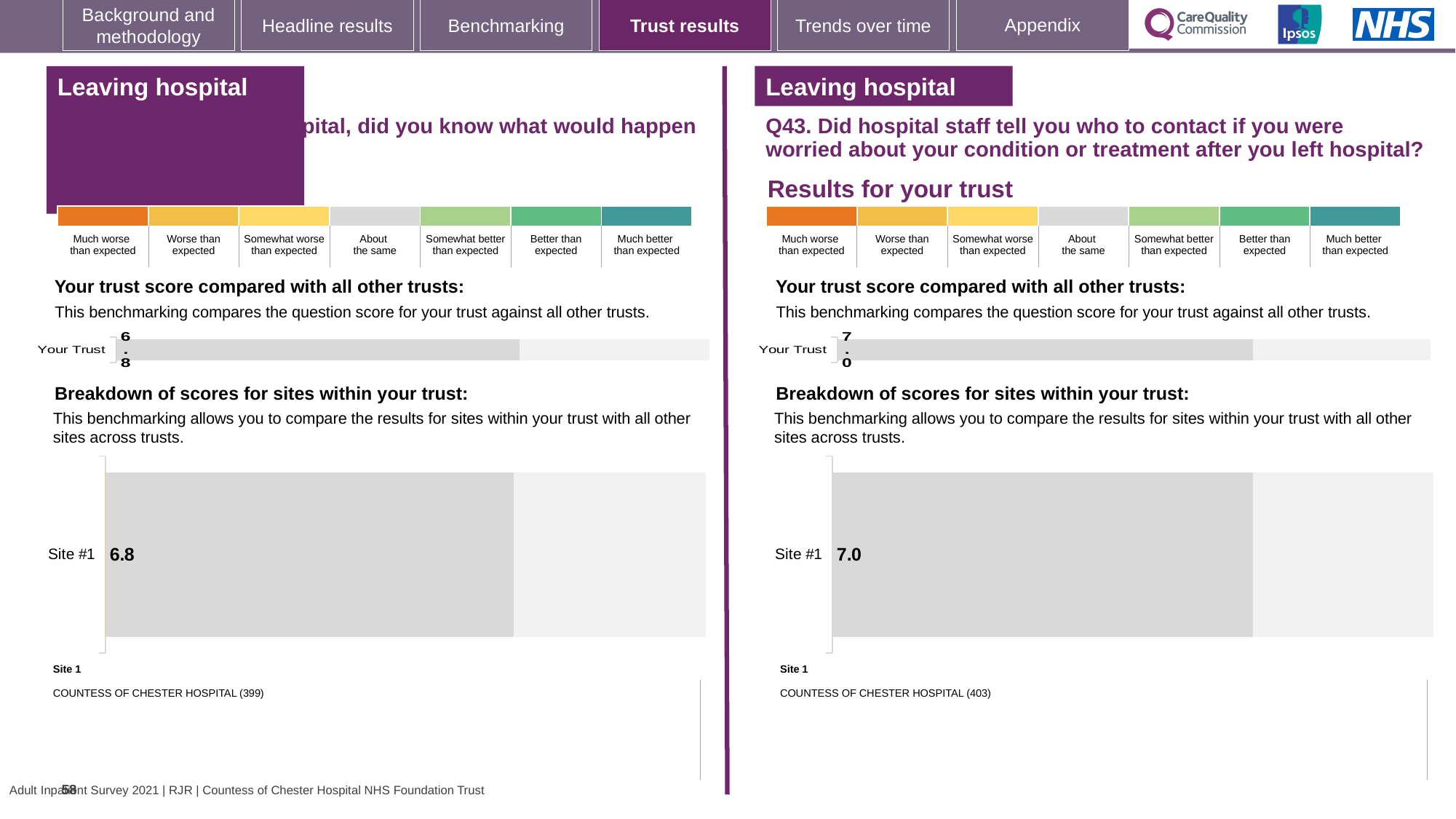
What kind of chart is used to show the Your Trust score on the left half of the slide? Bar chart On the left half of the slide, in the 'Breakdown of scores for sites within your trust' chart, what is the score for Site #1? 6.8 Which is larger: the Site #1 score on the left half of the slide or the Site #1 score on the right half (Q43)? Right half (Q43) What is the name of the site labelled Site 1 on the left half of the slide? COUNTESS OF CHESTER HOSPITAL (399) What is the difference between the Site #1 score on the right half of the slide (Q43) and the Site #1 score on the left half? 0.2 What is the name of the site labelled Site 1 on the right half of the slide (Q43)? COUNTESS OF CHESTER HOSPITAL (403) What kind of chart is used to show the Site #1 score on the right half of the slide (Q43)? Bar chart How many sites are shown in the 'Breakdown of scores for sites within your trust' chart on the left half of the slide? 1 How many sites are shown in the 'Breakdown of scores for sites within your trust' chart on the right half of the slide (Q43)? 1 On the right half of the slide (Q43), in the 'Breakdown of scores for sites within your trust' chart, what is the score for Site #1? 7.0 On the right half of the slide (Q43), in the 'Your trust score compared with all other trusts' chart, what is the value for Your Trust? 7.0 On the left half of the slide, in the 'Your trust score compared with all other trusts' chart, what is the value for Your Trust? 6.8